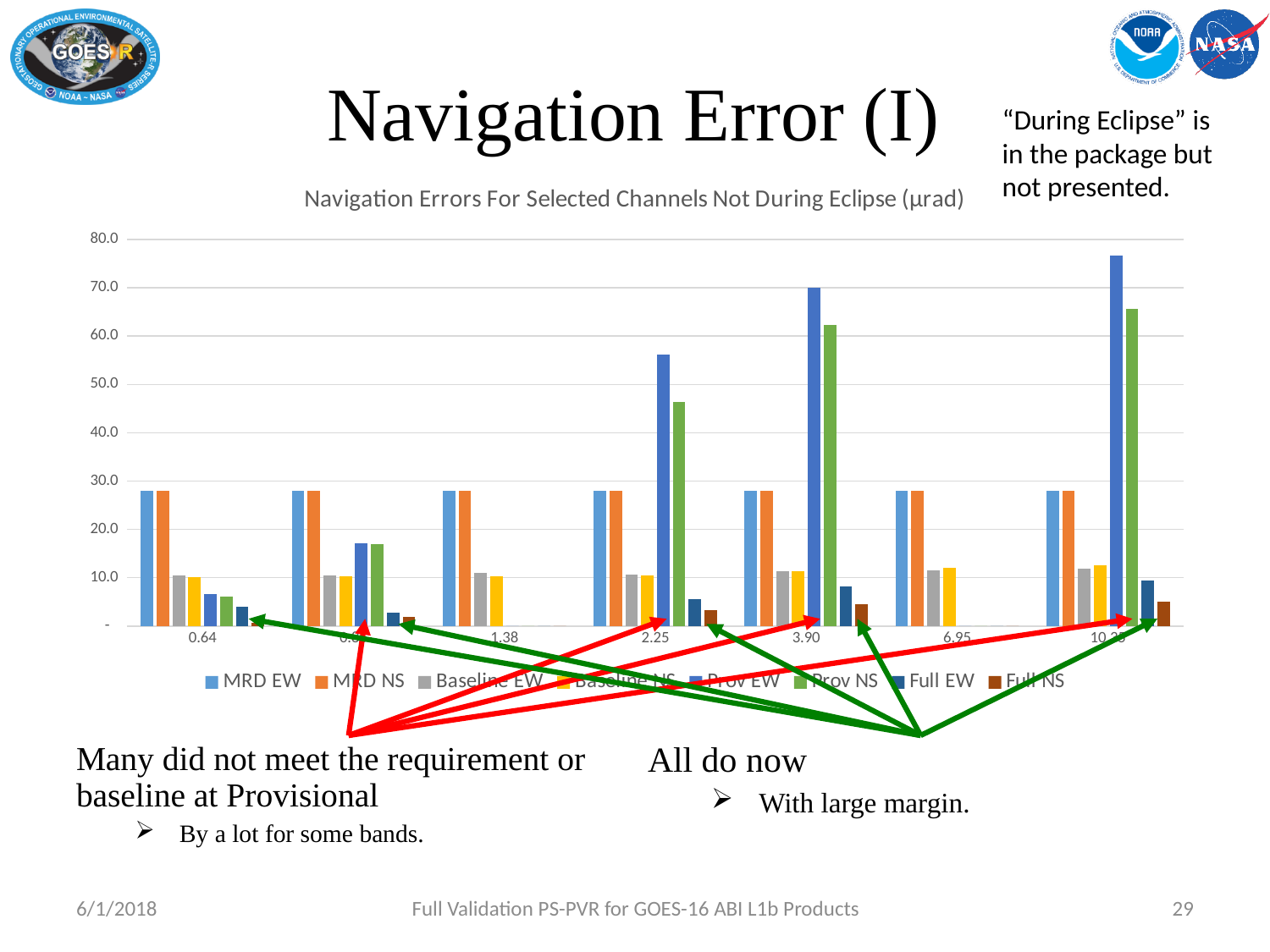
How many category groups are plotted along the x axis of the chart? 7 How many series does the chart legend list? 8 Is the value for Prov EW at 3.90 greater or less than 60? greater Which series is listed first in the chart legend? MRD EW At 2.25, which is larger: Prov EW or Prov NS? Prov EW What is the title of the chart? Navigation Errors For Selected Channels Not During Eclipse (μrad) What kind of chart is shown on the slide? bar chart Is the value for Prov NS at 0.64 greater or less than 10? less Is the value for Baseline EW at 6.95 greater or less than 20? less At 3.90, which series has the tallest bar? Prov EW